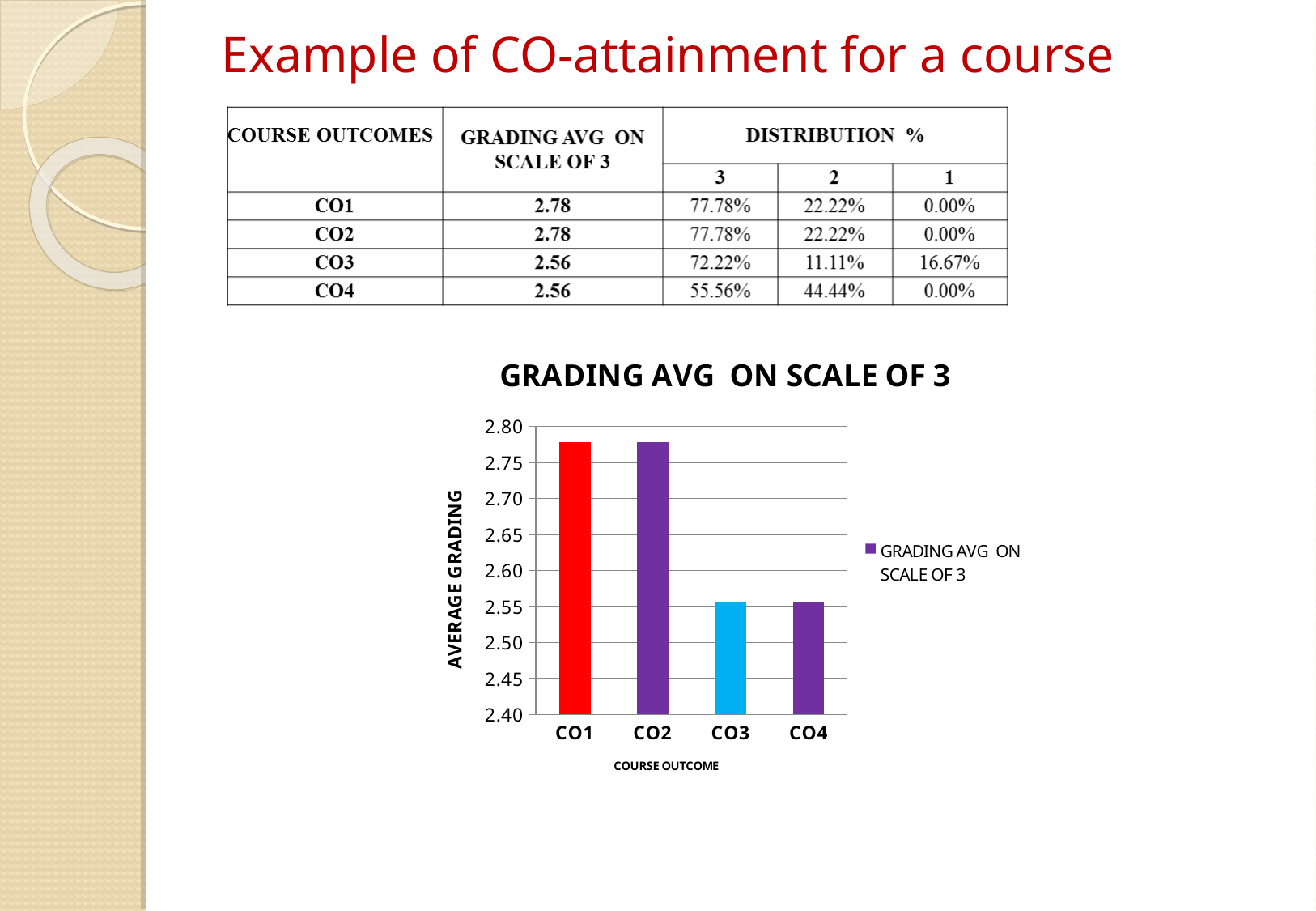
What is the difference between the grading averages of CO1 and CO3? 0.22 What is the grading average on scale of 3 for CO3? 2.56 What is the title of the chart? GRADING AVG ON SCALE OF 3 How many series does the chart legend list? 1 What is the label on the vertical axis of the chart? AVERAGE GRADING Is the value for CO4 in the chart greater or less than 2.50? greater How many course outcomes are plotted on the x axis of the chart? 4 Which has the larger grading average, CO2 or CO4? CO2 What is the grading average on scale of 3 for CO1? 2.78 Is the value for CO1 in the chart greater or less than 2.75? greater Is the value for CO3 in the chart greater or less than 2.60? less What kind of chart is shown on the slide? bar chart